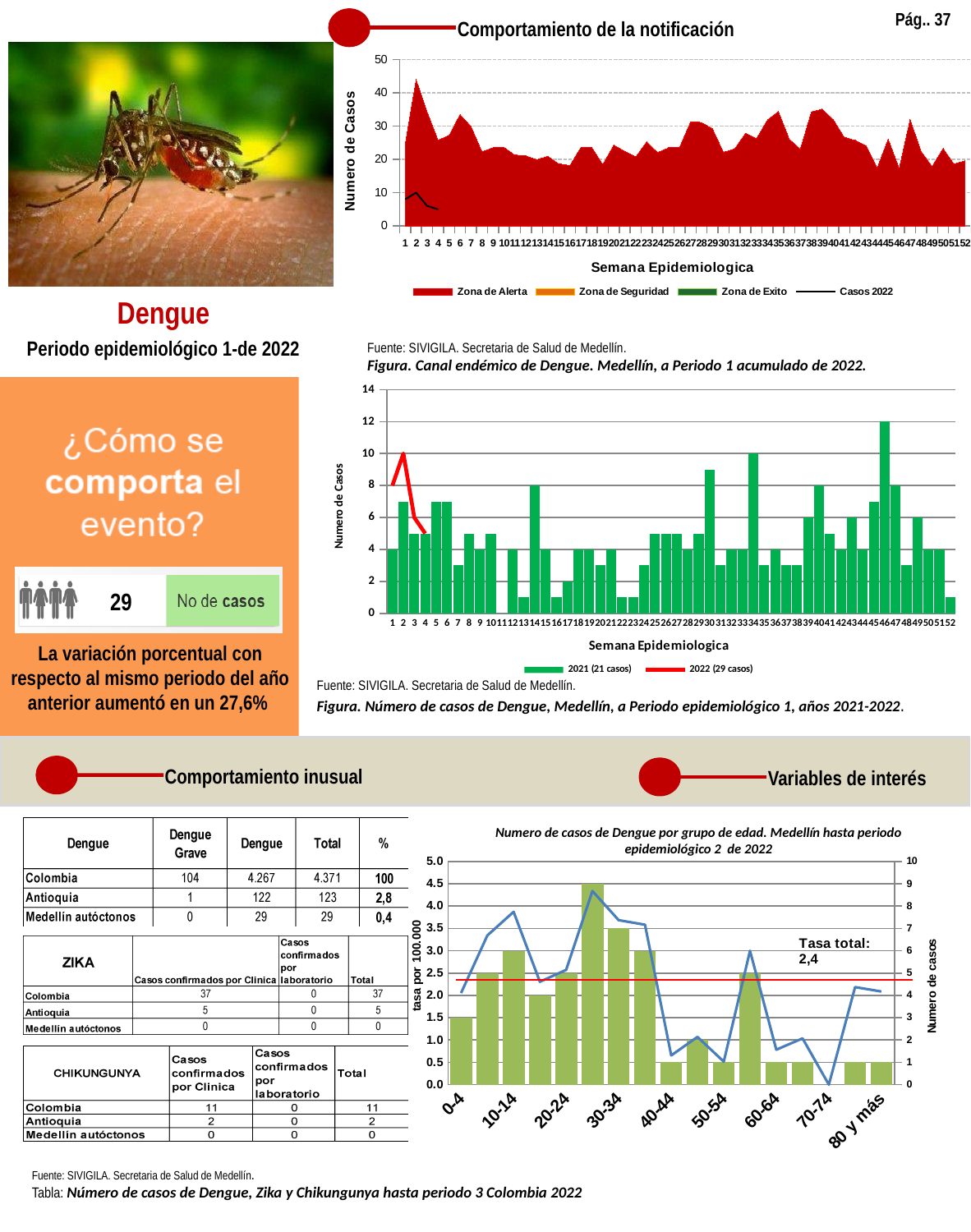
In the chart 'Número de casos de Dengue, Medellín, a Periodo epidemiológico 1, años 2021-2022', which epidemiological week has the highest 2021 bar? 46 In the chart titled 'Canal endémico de Dengue', what is the highest value shown on the y axis? 50 In the chart titled 'Canal endémico de Dengue', what is the label of the y axis? Numero de Casos In the chart 'Número de casos de Dengue, Medellín, a Periodo epidemiológico 1, años 2021-2022', what is the 2021 value for week 46? 12 In the chart 'Número de casos de Dengue, Medellín, a Periodo epidemiológico 1, años 2021-2022', what kind of chart is used for the 2021 series? bar chart In the chart 'Número de casos de Dengue, Medellín, a Periodo epidemiológico 1, años 2021-2022', is the 2021 value for week 33 greater or less than 8? less In the chart 'Numero de casos de Dengue por grupo de edad', what is the 'Tasa total' printed on the chart? 2,4 In the chart 'Número de casos de Dengue, Medellín, a Periodo epidemiológico 1, años 2021-2022', how many cases does the legend give for 2021? 21 casos In the chart titled 'Canal endémico de Dengue', how many entries does the legend list? 4 In the chart 'Número de casos de Dengue, Medellín, a Periodo epidemiológico 1, años 2021-2022', how many cases does the legend give for 2022? 29 casos In the chart 'Numero de casos de Dengue por grupo de edad', is the rate (bar) for the 10-14 age group greater or less than 2.5? greater In the chart 'Numero de casos de Dengue por grupo de edad', which has the taller bar, the 30-34 age group or the 40-44 age group? 30-34